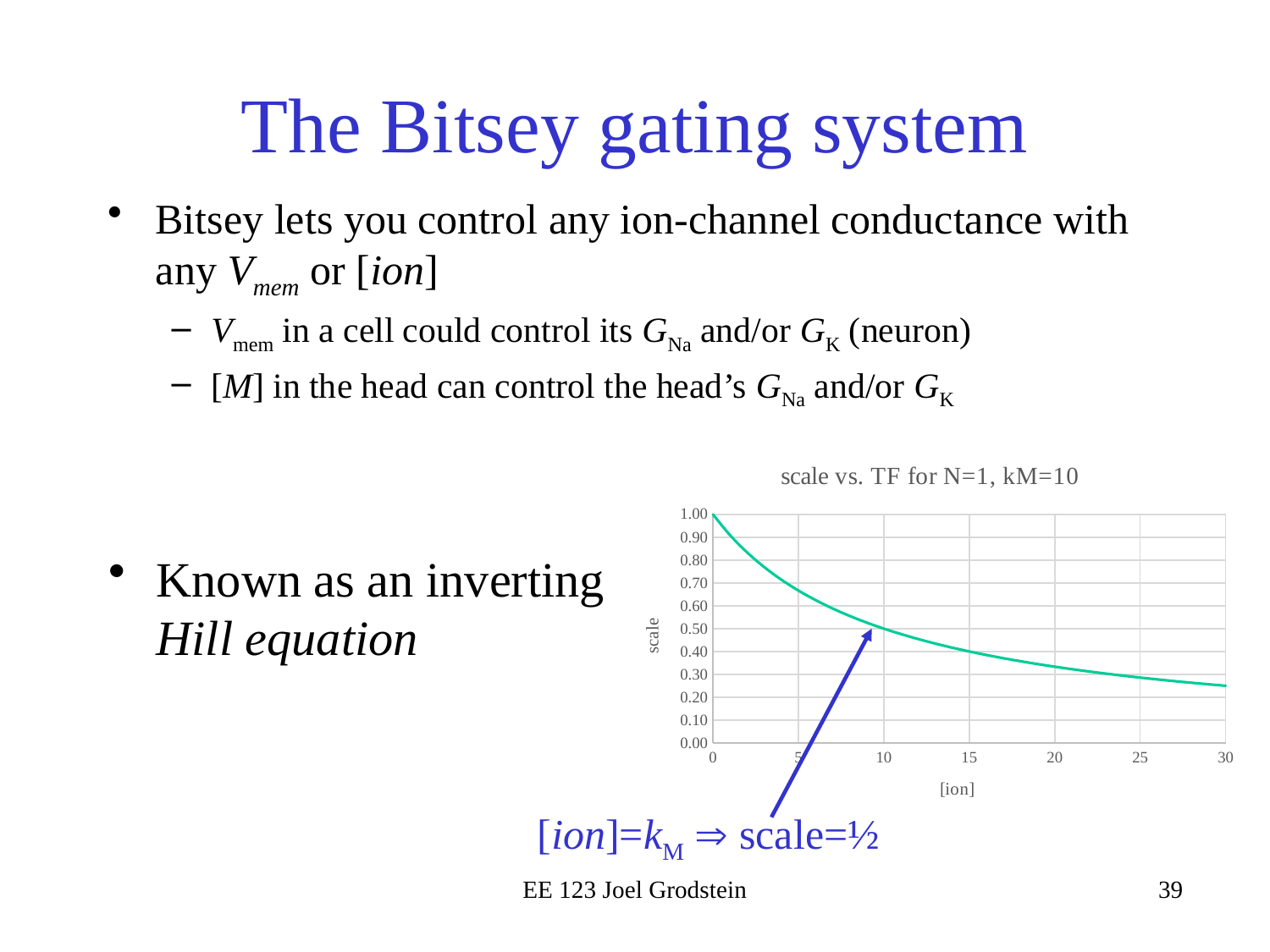
Does the scale value rise or fall as [ion] increases along the x axis? fall What kind of chart is shown on the slide? line chart At which [ion] value is the scale highest? 0 Is the scale value at [ion]=30 greater or less than 0.30? less Is the scale value at [ion]=5 greater or less than 0.60? greater Which is larger, the scale value at [ion]=5 or at [ion]=25? [ion]=5 At which [ion] value shown on the x axis is the scale lowest? 30 What is the scale value when [ion] is 0? 1.00 What is the scale value when [ion] is 10? 0.50 What is the title of the chart? scale vs. TF for N=1, kM=10 Is the scale value at [ion]=20 greater or less than 0.50? less What is the label of the x axis of the chart? [ion]